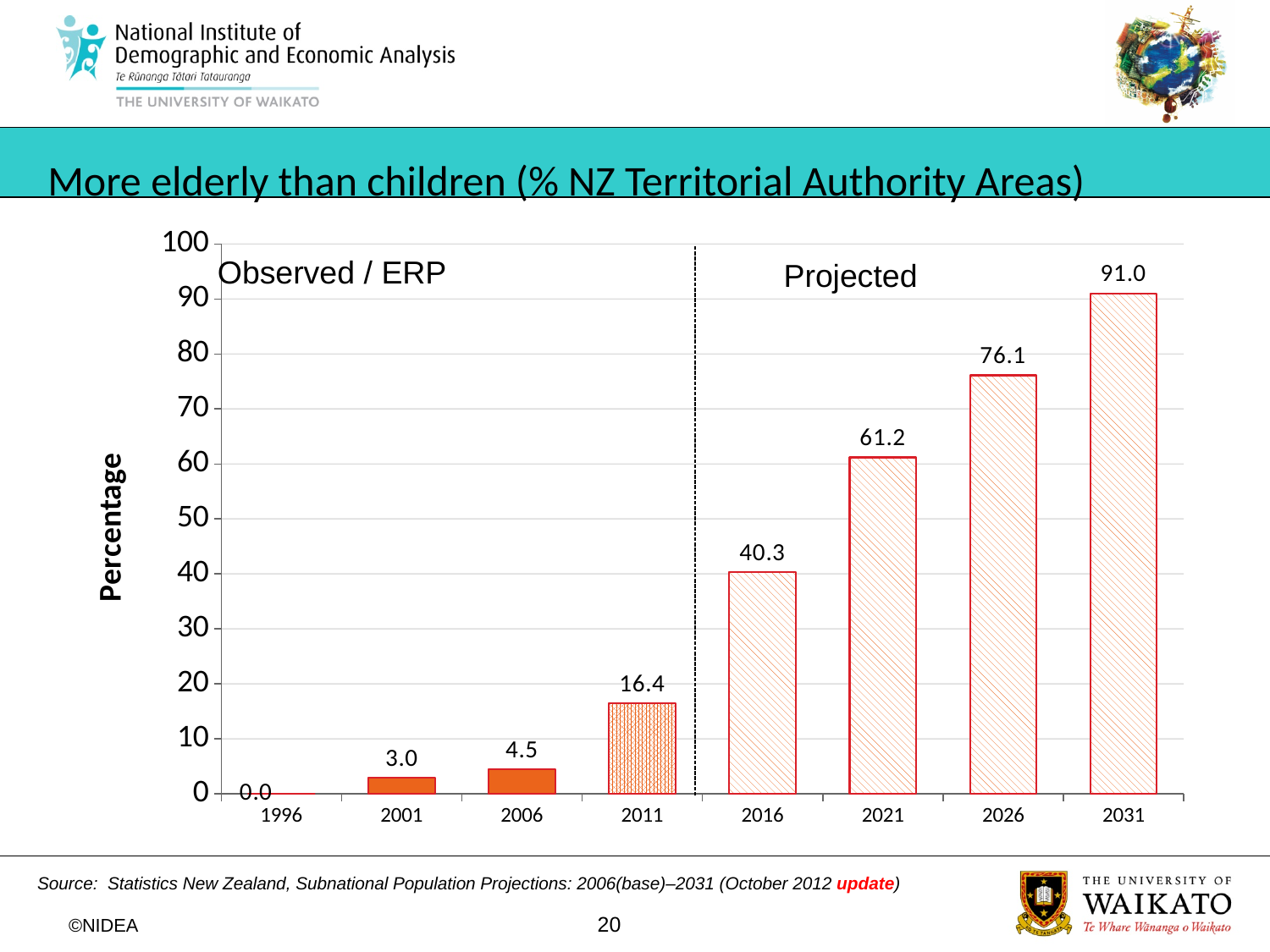
What kind of chart is this? bar chart Which year has the lowest value? 1996 What is the value for 2006? 4.5 Is the value for 2026 greater or less than 70? greater How many years are shown on the x axis? 8 What is the value for 2016? 40.3 Do the values rise or fall from 1996 to 2031? rise Which is larger, the value for 2011 or the value for 2006? 2011 What is the difference between the values for 2021 and 2016? 20.9 Which year has the highest value? 2031 What is the label on the y axis? Percentage What is the value for 2031? 91.0